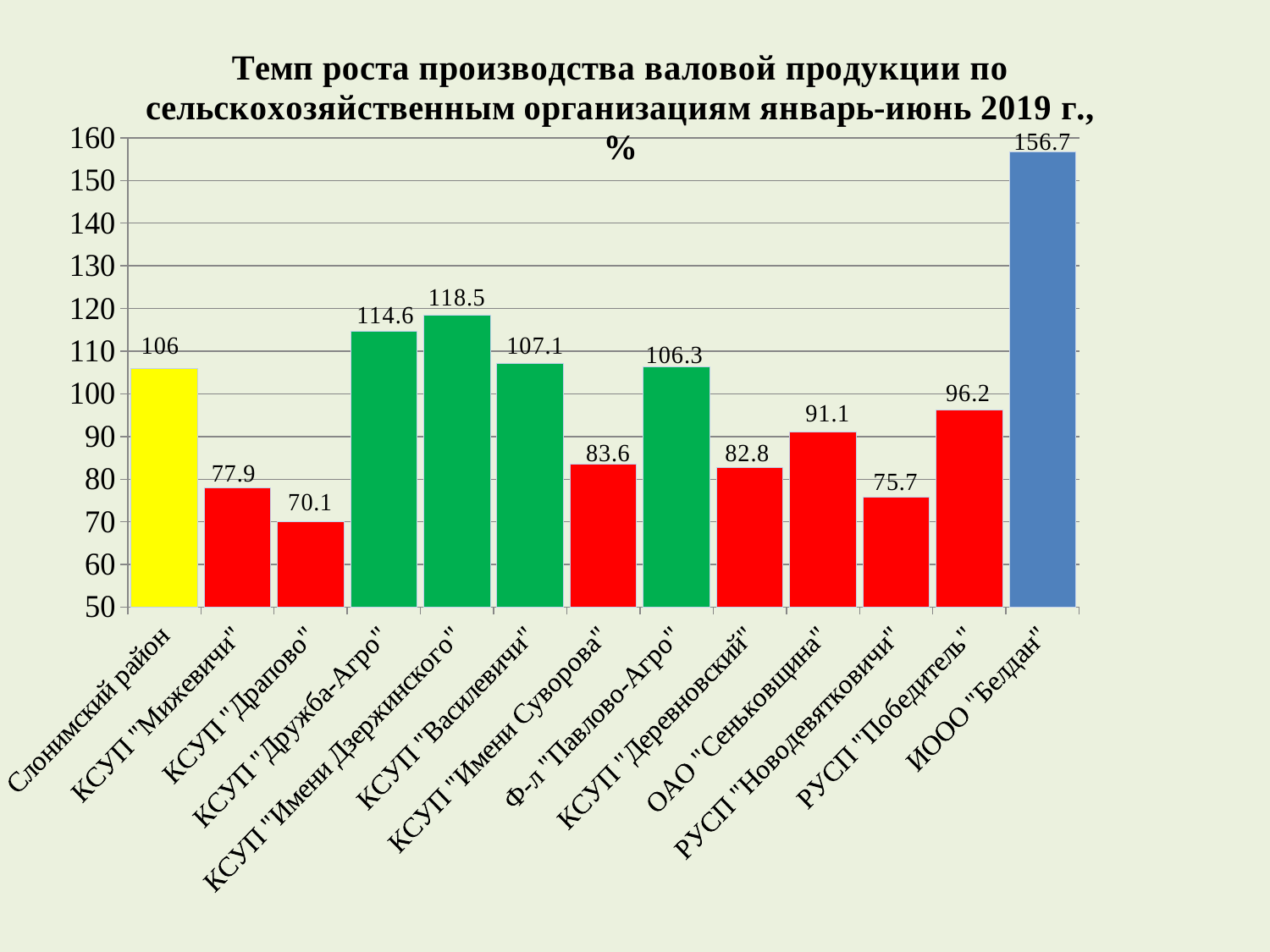
What is the difference between the values for КСУП "Дружба-Агро" and КСУП "Драпово"? 44.5 What colour is the bar for ИООО "Белдан"? Blue What is the value for ИООО "Белдан"? 156.7 What is the value for Слонимский район? 106 How many categories are shown on the x axis? 13 What kind of chart is shown on the slide? Bar chart What is the value for КСУП "Драпово"? 70.1 What is the difference between the values for ИООО "Белдан" and КСУП "Имени Дзержинского"? 38.2 Which category has the highest value? ИООО "Белдан" Which is larger, the value for КСУП "Мижевичи" or the value for РУСП "Победитель"? РУСП "Победитель" Which category has the lowest value? КСУП "Драпово" What is the value for ОАО "Сеньковщина"? 91.1